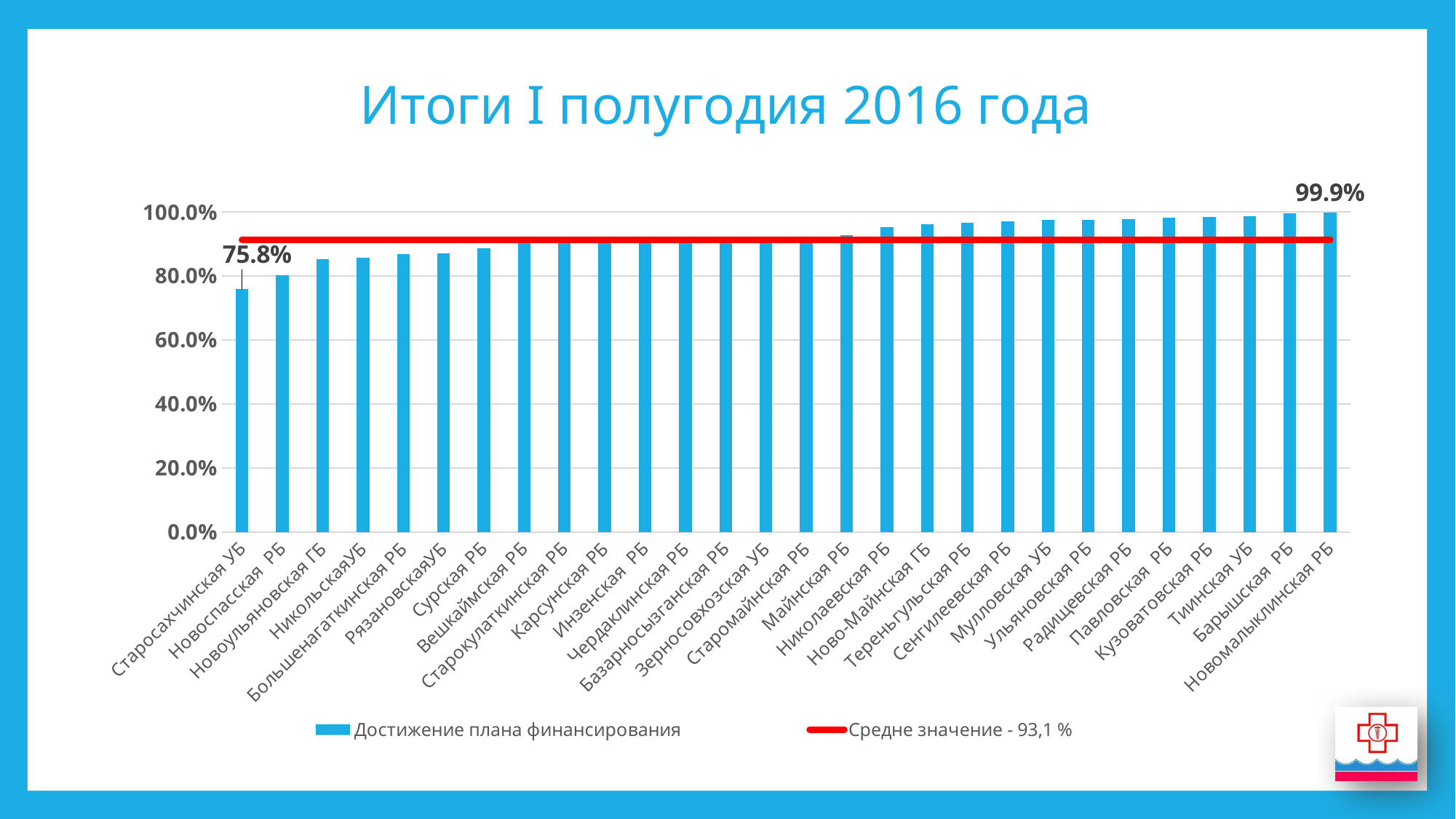
How many entries does the legend list? 2 Is the value for Старосахчинская УБ greater or less than 80%? less What is the difference between the values for Новомалыклинская РБ and Старосахчинская УБ? 24.1 percentage points What is the value for Новомалыклинская РБ? 99.9% What is the value for Старосахчинская УБ? 75.8% Which category has the highest value? Новомалыклинская РБ Which category has the lowest value? Старосахчинская УБ Is the value for Новоульяновская ГБ greater or less than 80%? greater How many categories are shown on the x axis? 28 What kind of chart is shown on the slide? combination bar and line chart Do the bar values rise or fall from left to right along the x axis? rise Which is larger, the value for Сурская РБ or the value for Новоспасская РБ? Сурская РБ